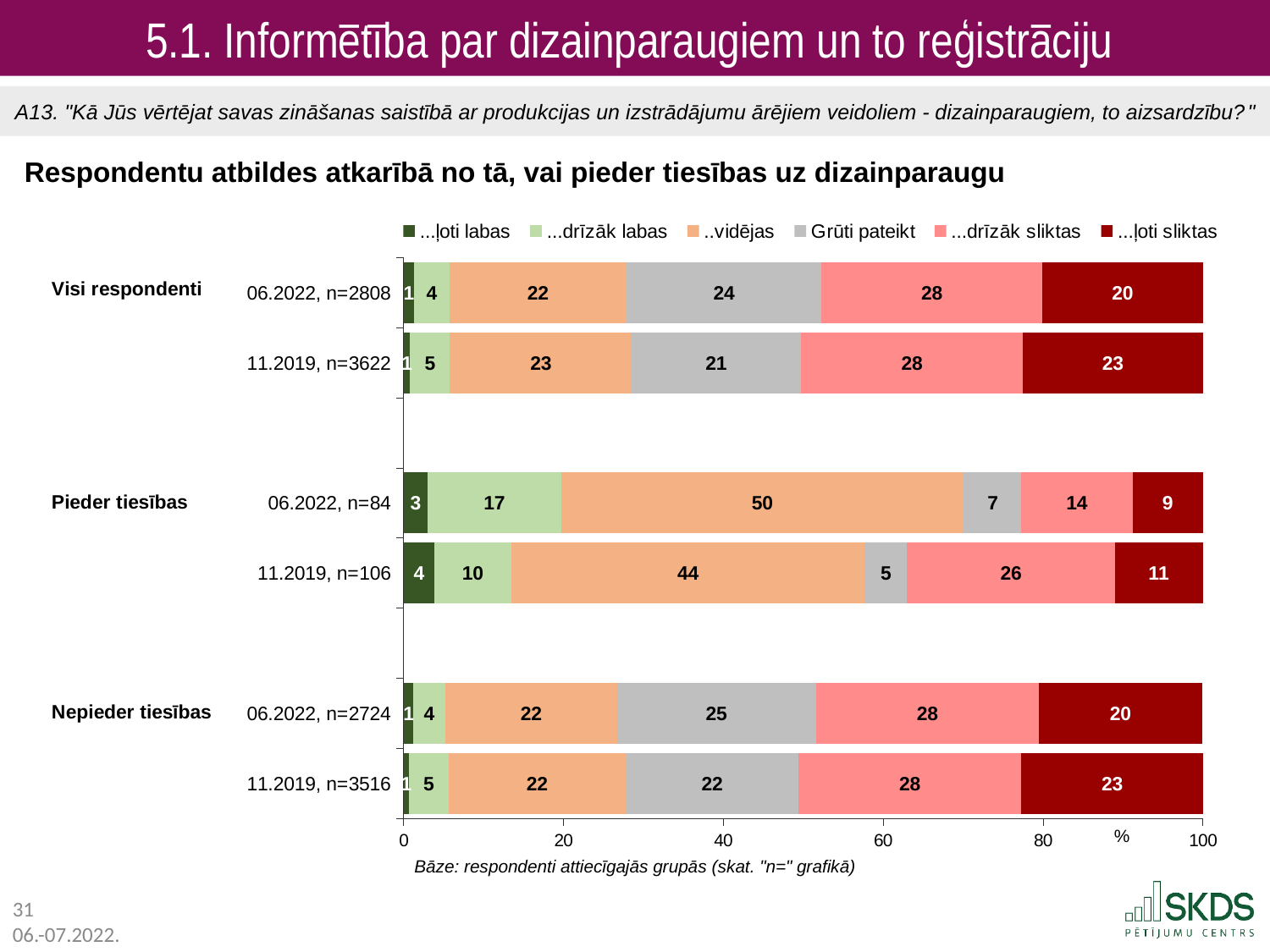
What is the value of "..vidējas" for Pieder tiesības, 06.2022, n=84? 50 What is the value of "...ļoti sliktas" for Visi respondenti, 11.2019, n=3622? 23 How many series does the legend list? 6 What is the value of "Grūti pateikt" for Nepieder tiesības, 06.2022, n=2724? 25 What is the value of "...drīzāk sliktas" for Pieder tiesības, 11.2019, n=106? 26 Which series is shown in dark red in the legend? ...ļoti sliktas Which is larger: the "...ļoti sliktas" value for Visi respondenti 06.2022 (n=2808) or for Visi respondenti 11.2019 (n=3622)? Visi respondenti, 11.2019, n=3622 How many bars are plotted in the chart? 6 Which bar has the lowest value for "Grūti pateikt"? Pieder tiesības, 11.2019, n=106 What is the difference between the "...drīzāk labas" values for Pieder tiesības 06.2022 (n=84) and Pieder tiesības 11.2019 (n=106)? 7 What kind of chart is shown on the slide? Stacked bar chart Which bar has the highest value for "..vidējas"? Pieder tiesības, 06.2022, n=84